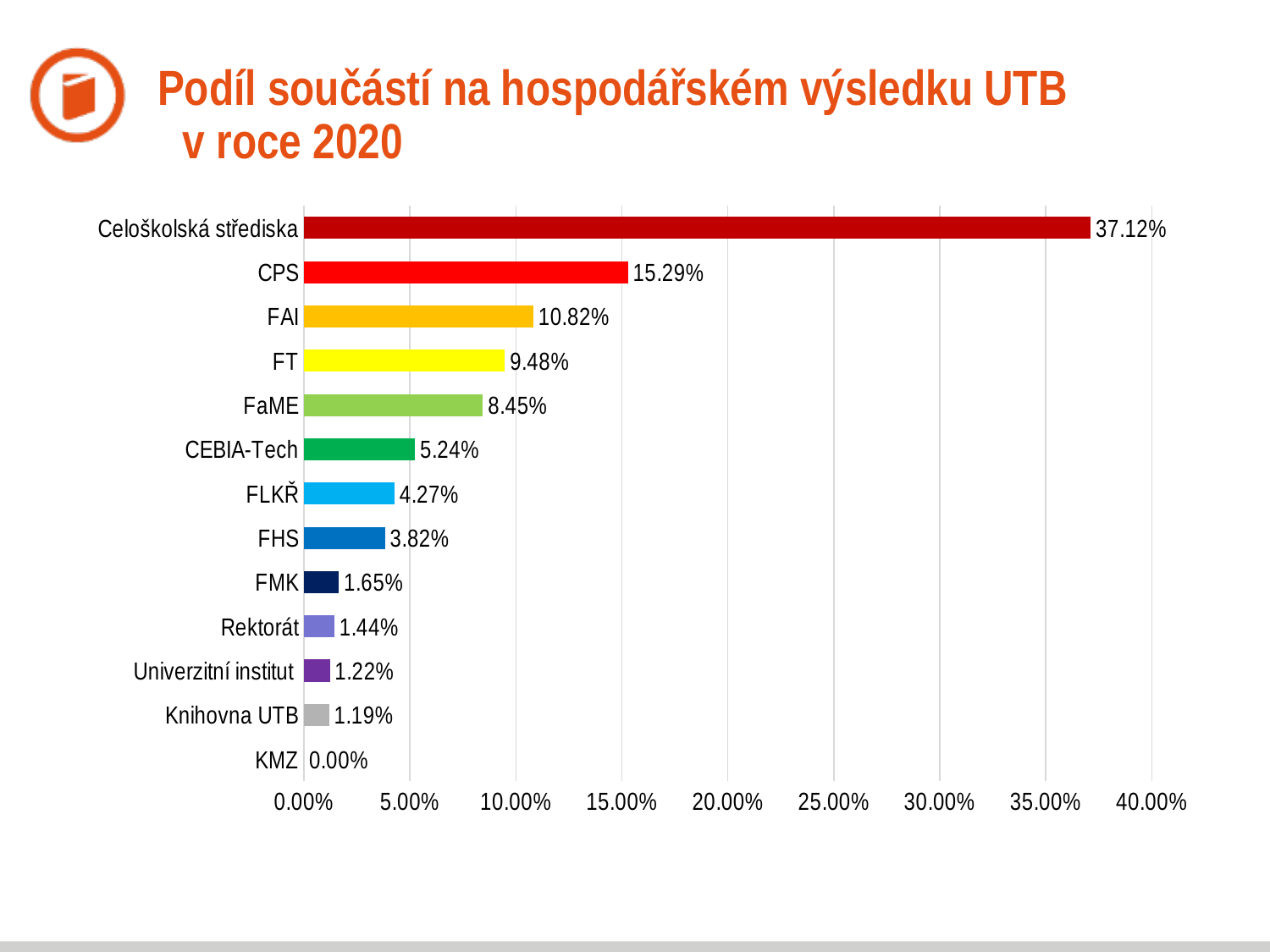
Which category has the highest value? Celoškolská střediska Which category has the lowest value? KMZ What is the value for CPS? 15.29% Is the value for CEBIA-Tech greater or less than 5.00%? greater What is the value for FaME? 8.45% How many categories are shown in the chart? 13 What is the difference between the values for Celoškolská střediska and CPS? 21.83% What is the value for Knihovna UTB? 1.19% What kind of chart is shown on the slide? Bar chart What is the difference between the values for FAI and FT? 1.34% What is the title of the slide? Podíl součástí na hospodářském výsledku UTB v roce 2020 Which is larger, the value for FLKŘ or the value for FHS? FLKŘ